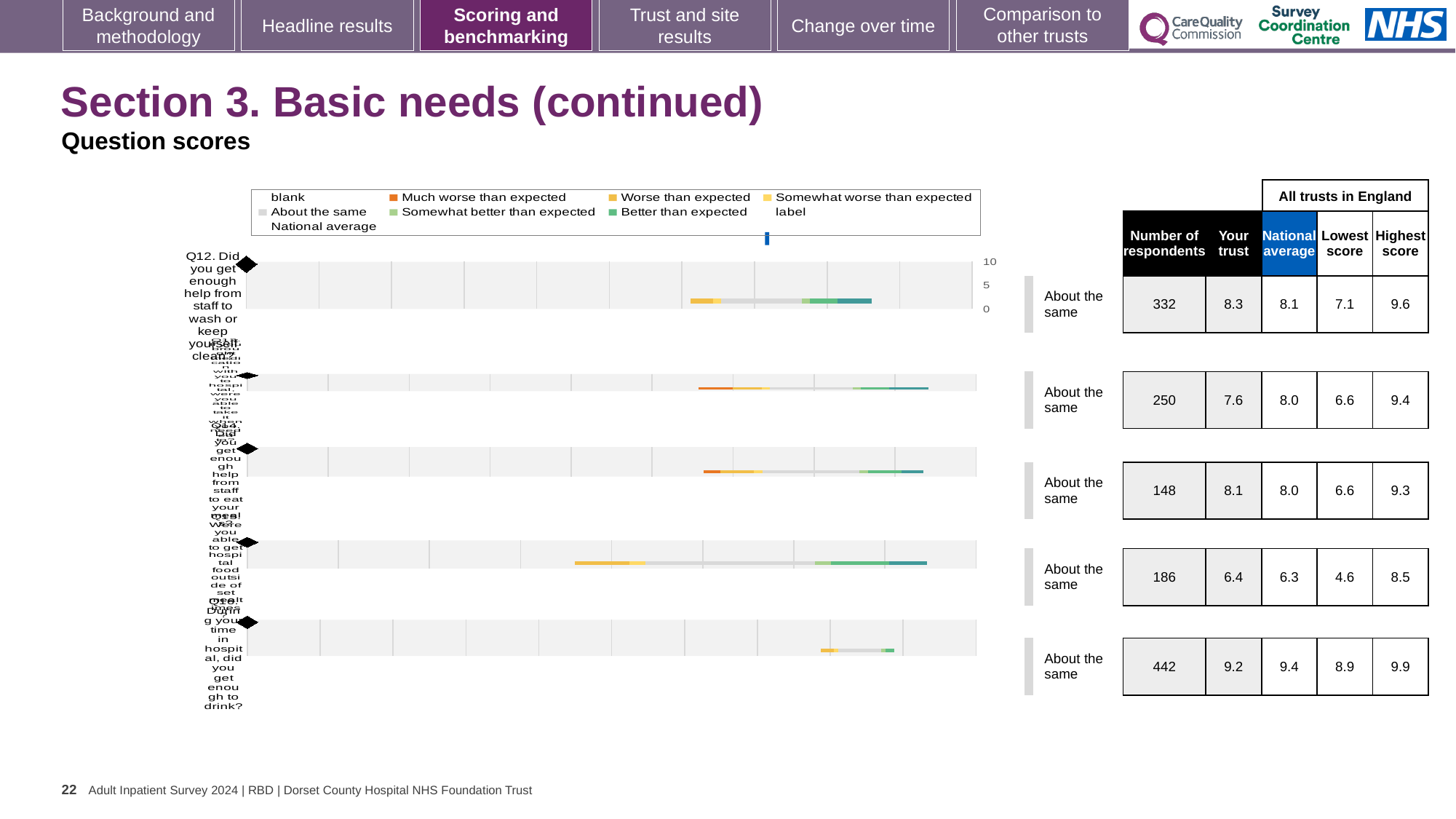
What is the 'Your trust' score for the first row (Q12, help from staff to wash or keep yourself clean)? 8.3 Which row has the highest 'Your trust' score? the bottom row (Q16), 9.2 What kind of chart is used to show the question scores on this slide? bar chart How many respondents are shown for the bottom row (Q16, enough to drink)? 442 What benchmark category is shown next to every row of the chart? About the same For the third row (148 respondents), what is the difference between the 'Your trust' score and the national average? 0.1 What is the national average for the fourth row (Q15, hospital food outside of set meal times)? 6.3 How many question rows (bars) are plotted in the chart? 5 Which row has the lowest 'Your trust' score? the fourth row (Q15), 6.4 For the first row (Q12), what is the difference between the highest score and the lowest score across all trusts in England? 2.5 For the second row (250 respondents), which is larger: the 'Your trust' score or the national average? National average Which column header in the table is highlighted in blue? National average